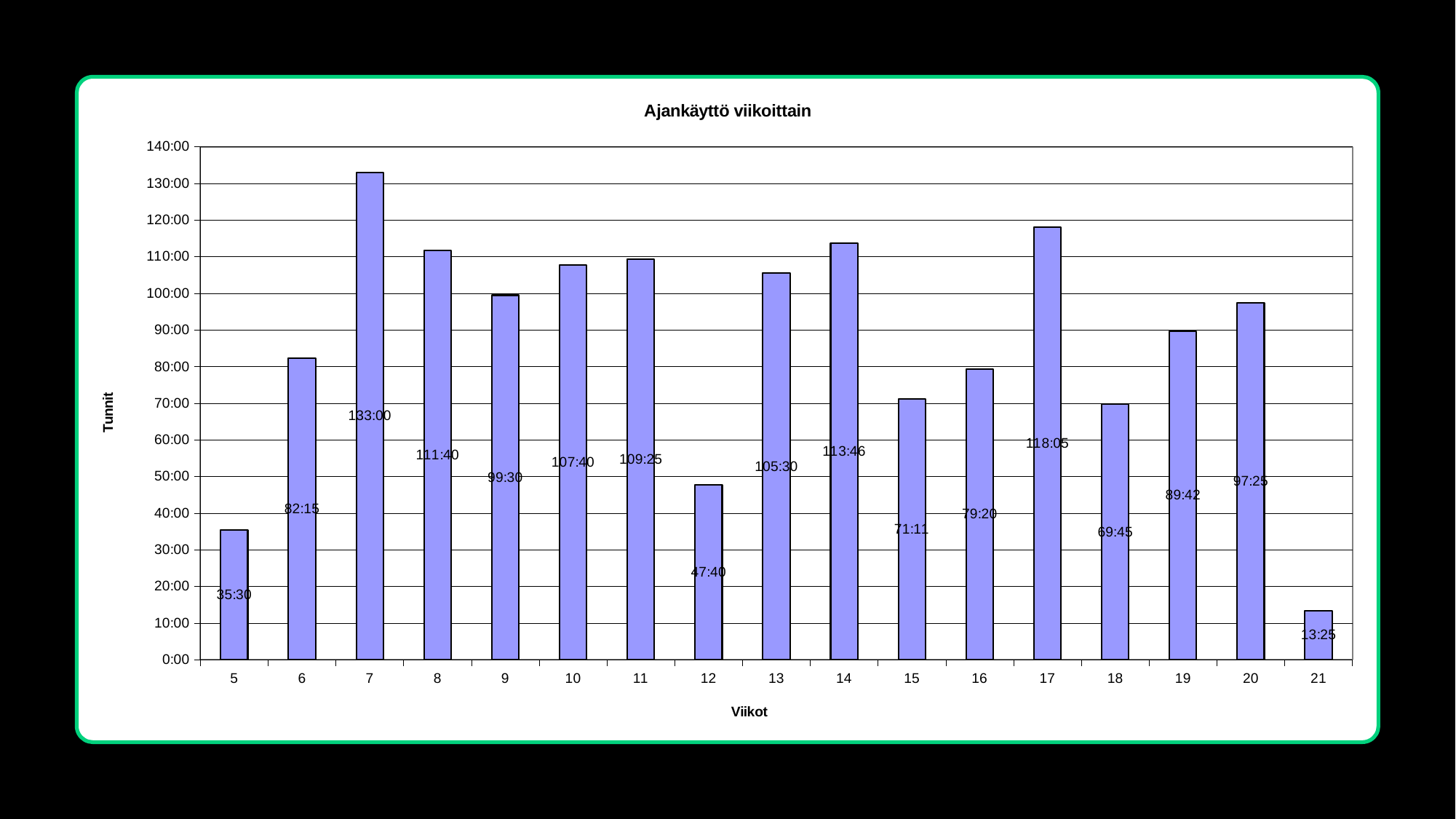
How many weeks are shown on the x axis? 17 What is the value for week 7? 133:00 What is the difference between the values for week 6 and week 5? 46:45 What is the difference between the values for week 7 and week 21? 119:35 Which week has the highest value? 7 Which is larger, the value for week 14 or the value for week 13? week 14 What is the value for week 12? 47:40 What is the value for week 17? 118:05 What kind of chart is this? bar chart What is the title of the chart? Ajankäyttö viikoittain Is the value for week 20 greater or less than 90:00? greater Which week has the lowest value? 21